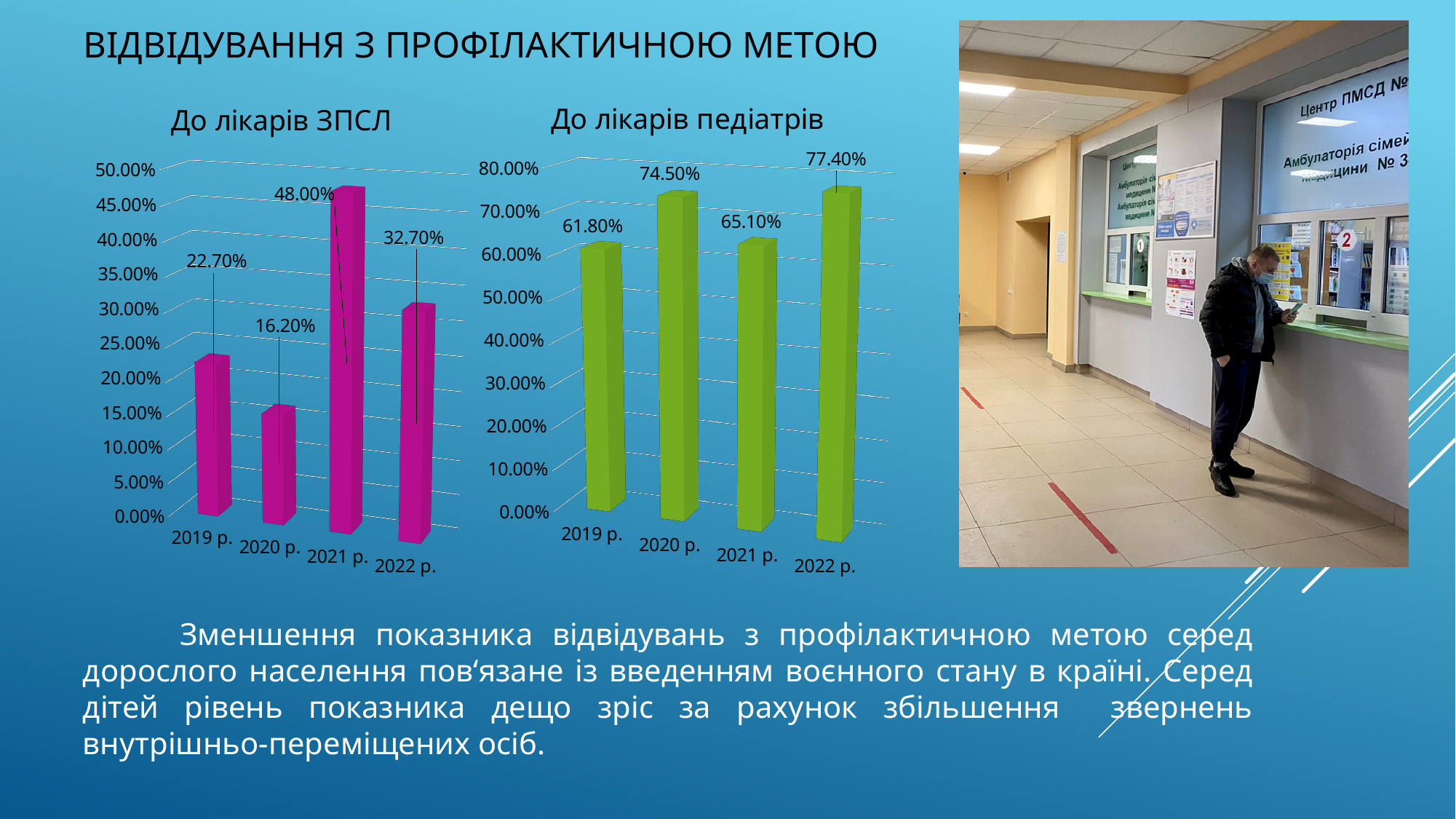
In the chart titled "До лікарів педіатрів", which is larger, the value for 2020 р. or the value for 2021 р.? 2020 р. In the chart titled "До лікарів педіатрів", what is the difference between the values for 2022 р. and 2019 р.? 15.60% In the chart titled "До лікарів ЗПСЛ", what is the value for 2021 р.? 48.00% In the chart titled "До лікарів ЗПСЛ", what is the difference between the values for 2021 р. and 2022 р.? 15.30% In the chart titled "До лікарів педіатрів", what is the value for 2019 р.? 61.80% What kind of chart is the chart titled "До лікарів педіатрів"? Bar chart In the chart titled "До лікарів педіатрів", which year has the lowest value? 2019 р. In the chart titled "До лікарів ЗПСЛ", which year has the highest value? 2021 р. In the chart titled "До лікарів ЗПСЛ", what is the value for 2020 р.? 16.20% How many years are shown on the x axis of the chart titled "До лікарів ЗПСЛ"? 4 In the chart titled "До лікарів ЗПСЛ", which year has the lowest value? 2020 р. In the chart titled "До лікарів педіатрів", what is the value for 2022 р.? 77.40%